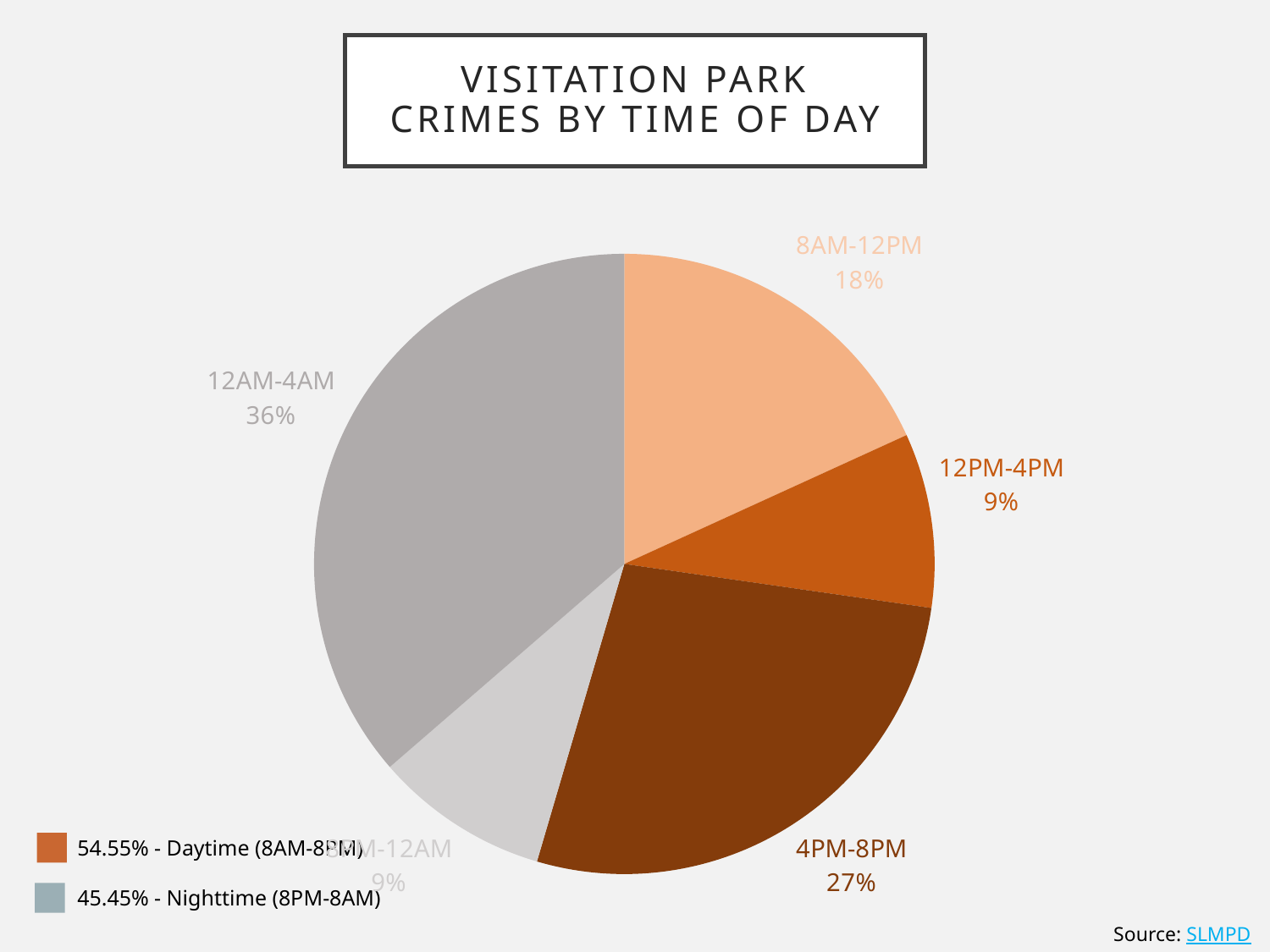
How many slices does the pie chart have? 5 According to the legend, what percentage of crimes occurred during the daytime (8AM-8PM)? 54.55% What percentage of Visitation Park crimes occurred between 12AM and 4AM? 36% What percentage is shown for the 12PM-4PM time slot? 9% What type of chart is shown on the slide? Pie chart Which slice is larger, 4PM-8PM or 8AM-12PM? 4PM-8PM What percentage of crimes is shown for the 4PM-8PM slice? 27% How many percentage points larger is the 12AM-4AM slice than the 4PM-8PM slice? 9 percentage points Which time of day has the largest share of crimes? 12AM-4AM What share of crimes occurred between 8AM and 12PM? 18% How many percentage points larger is the 8AM-12PM slice than the 12PM-4PM slice? 9 percentage points According to the legend, what percentage of crimes occurred during the nighttime (8PM-8AM)? 45.45%